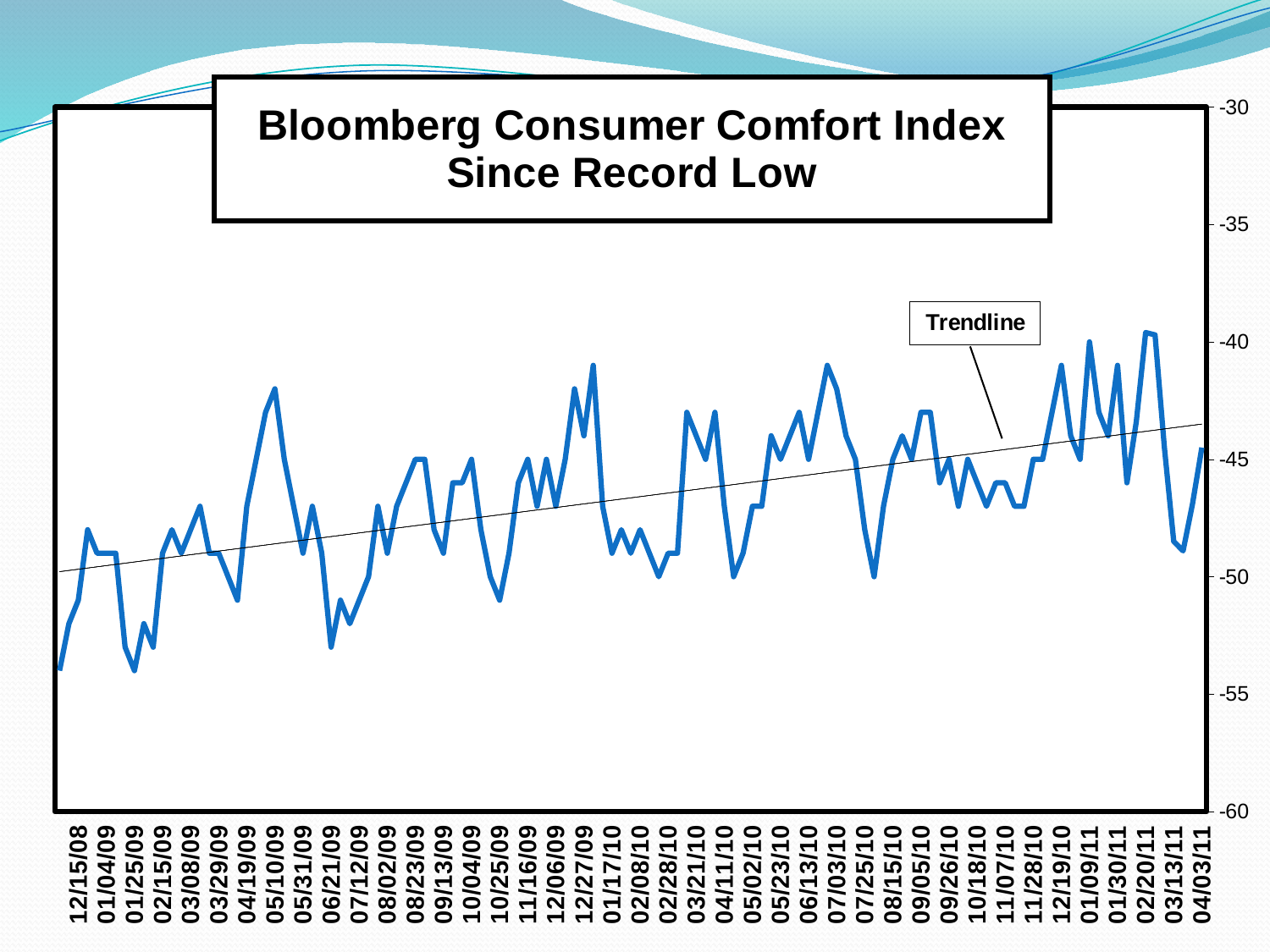
Is the value for 12/15/08 greater or less than -50? less What is the label on the thin straight line drawn across the chart? Trendline What is the title of the chart? Bloomberg Consumer Comfort Index Since Record Low Which is larger, the value for 12/15/08 or the value for 04/03/11? 04/03/11 What are the lowest and highest values shown on the vertical axis? -60 and -30 Overall, do the values of the Bloomberg Consumer Comfort Index rise or fall from 12/15/08 to 04/03/11? Rise Is the value for 06/21/09 greater or less than -50? less Is the value for 05/10/09 greater or less than -45? greater What kind of chart is shown on the slide? Line chart Which is larger, the value for 05/10/09 or the value for 06/21/09? 05/10/09